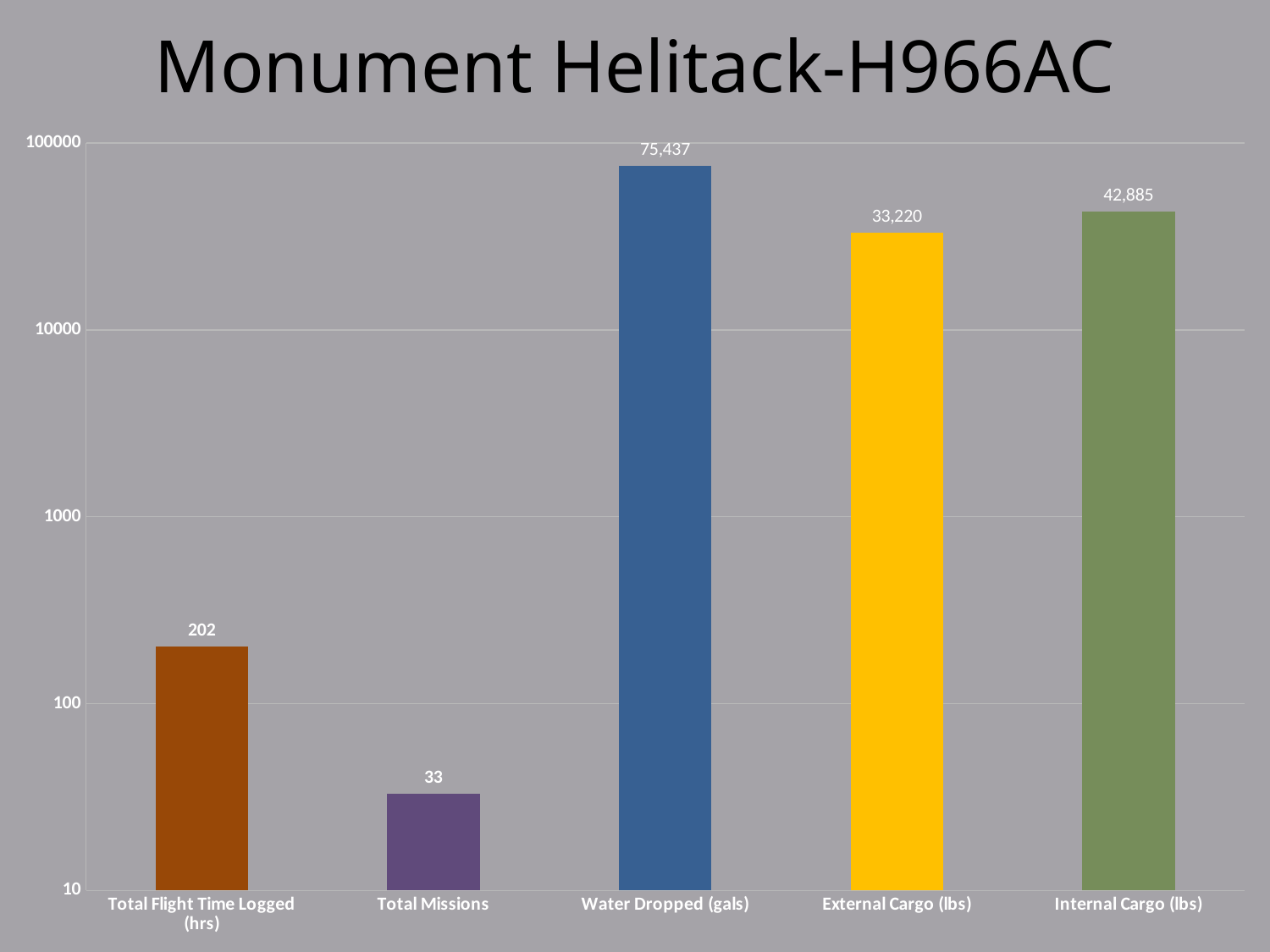
Which is larger, Internal Cargo (lbs) or External Cargo (lbs)? Internal Cargo (lbs) What is the value for Total Flight Time Logged (hrs)? 202 What is the value for External Cargo (lbs)? 33,220 How many categories are shown on the chart? 5 Which category has the highest value? Water Dropped (gals) What kind of chart is shown on the slide? Bar chart What is the difference between Internal Cargo (lbs) and External Cargo (lbs)? 9,665 What is the value for Total Missions? 33 What is the value for Internal Cargo (lbs)? 42,885 What is the title of the chart? Monument Helitack-H966AC What is the value for Water Dropped (gals)? 75,437 Which category has the lowest value? Total Missions